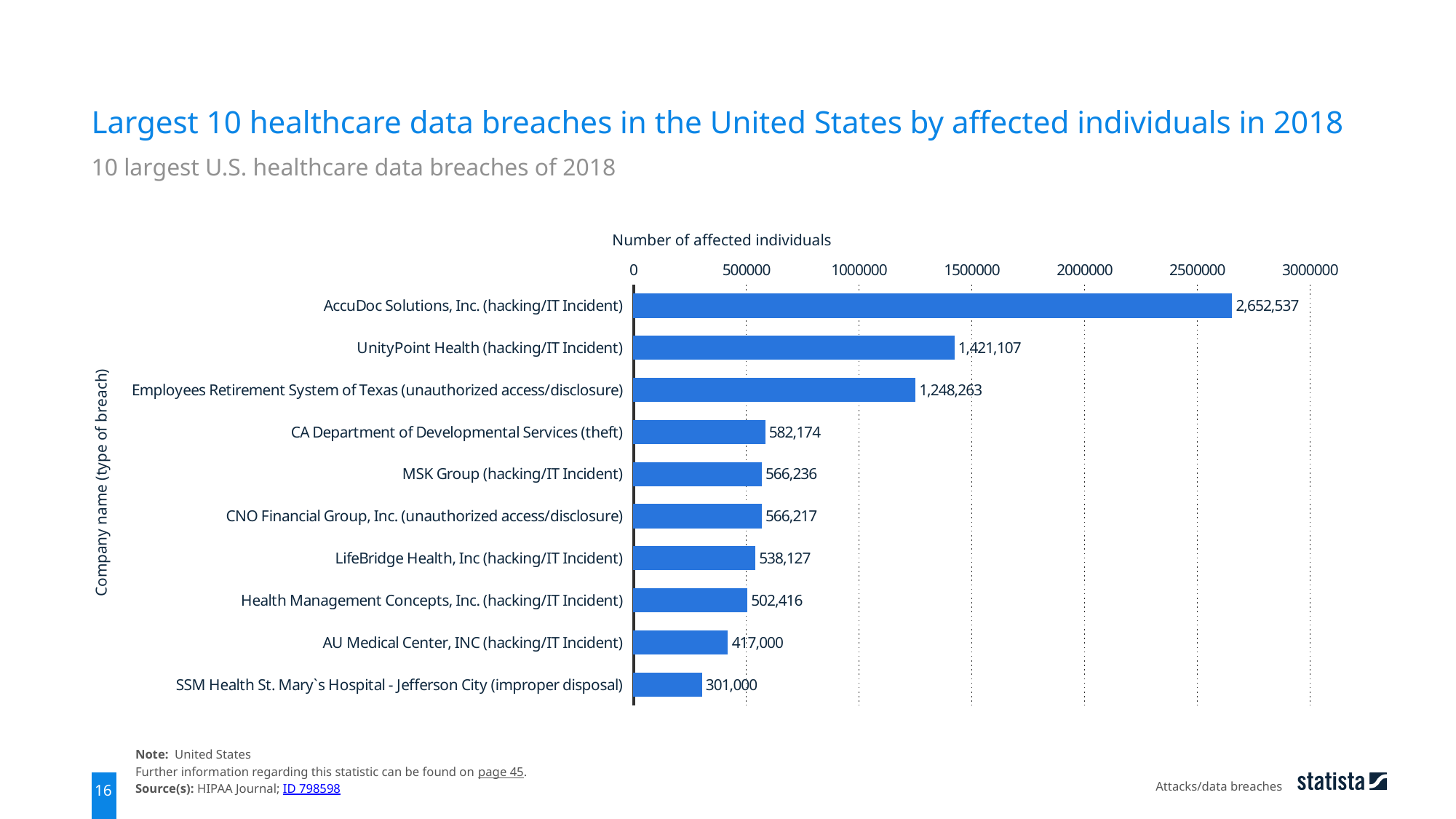
What type of chart is shown on the slide? Bar chart What value is shown for SSM Health St. Mary`s Hospital - Jefferson City (improper disposal)? 301,000 Which company has the largest number of affected individuals? AccuDoc Solutions, Inc. (hacking/IT Incident) Is the value for Health Management Concepts, Inc. greater or less than 500000? greater What is the difference in affected individuals between AccuDoc Solutions, Inc. and UnityPoint Health? 1,231,430 What is the difference in affected individuals between AU Medical Center, INC and SSM Health St. Mary`s Hospital - Jefferson City? 116,000 How many companies are shown in the chart? 10 Which has more affected individuals: Employees Retirement System of Texas or CA Department of Developmental Services? Employees Retirement System of Texas Which company has the smallest number of affected individuals? SSM Health St. Mary`s Hospital - Jefferson City (improper disposal) What is the label of the horizontal axis? Number of affected individuals How many affected individuals are shown for AccuDoc Solutions, Inc. (hacking/IT Incident)? 2,652,537 What is the number of affected individuals for UnityPoint Health (hacking/IT Incident)? 1,421,107